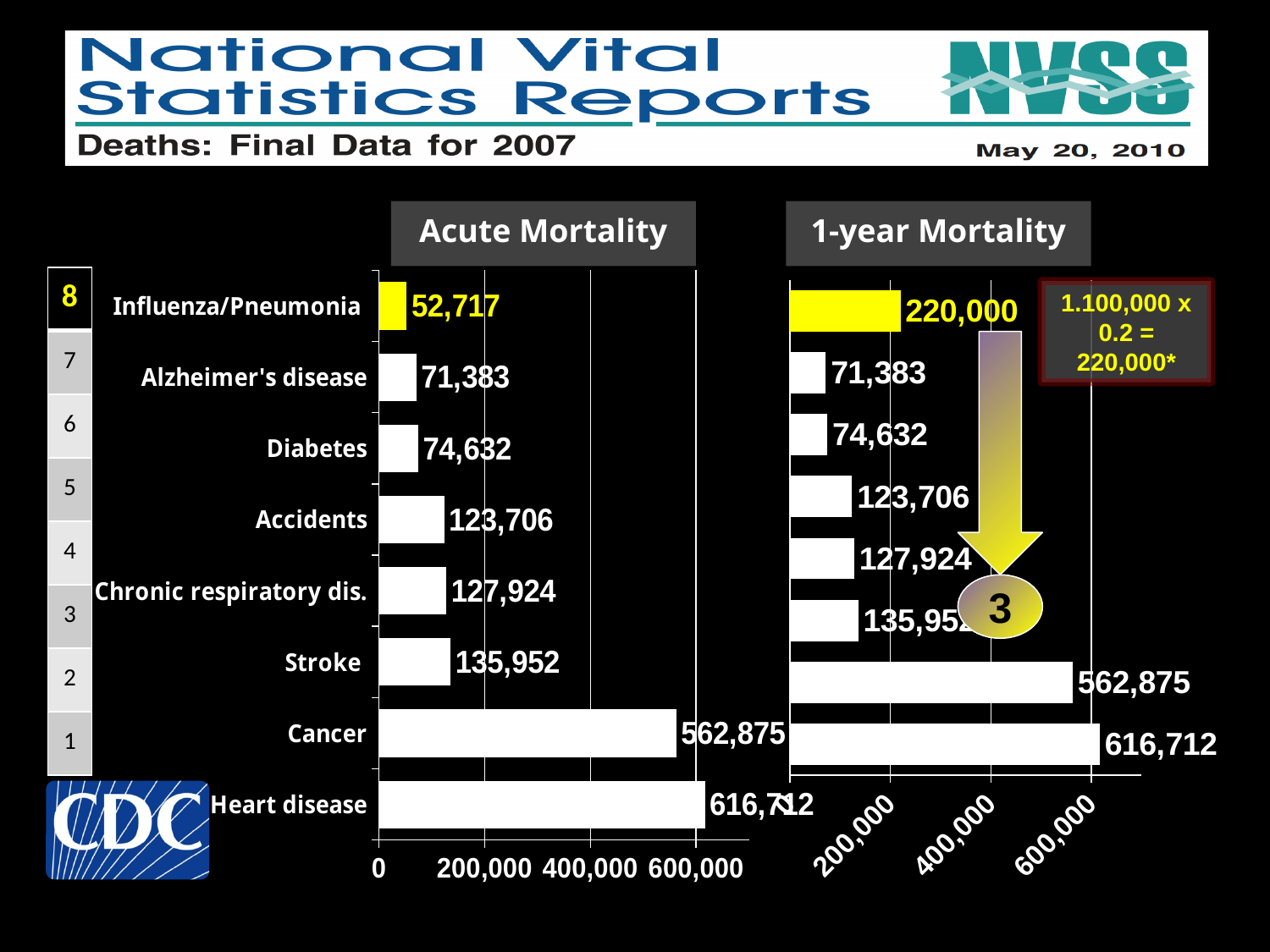
In the 1-year Mortality chart, which category has the lowest value? Alzheimer's disease In the Acute Mortality chart, which category has the highest value? Heart disease What is the difference between the Influenza/Pneumonia value in the 1-year Mortality chart and in the Acute Mortality chart? 167,283 What type of chart is the Acute Mortality chart? Bar chart In the 1-year Mortality chart, is the value for Influenza/Pneumonia greater or less than 200,000? greater In the Acute Mortality chart, which is larger: Accidents or Stroke? Stroke In the 1-year Mortality chart, what is the value for Influenza/Pneumonia? 220,000 In the Acute Mortality chart, what is the value for Cancer? 562,875 How many categories are shown in the Acute Mortality chart? 8 In the Acute Mortality chart, which category has the lowest value? Influenza/Pneumonia In the Acute Mortality chart, what is the value for Influenza/Pneumonia? 52,717 In the Acute Mortality chart, what is the difference between Heart disease and Cancer? 53,837